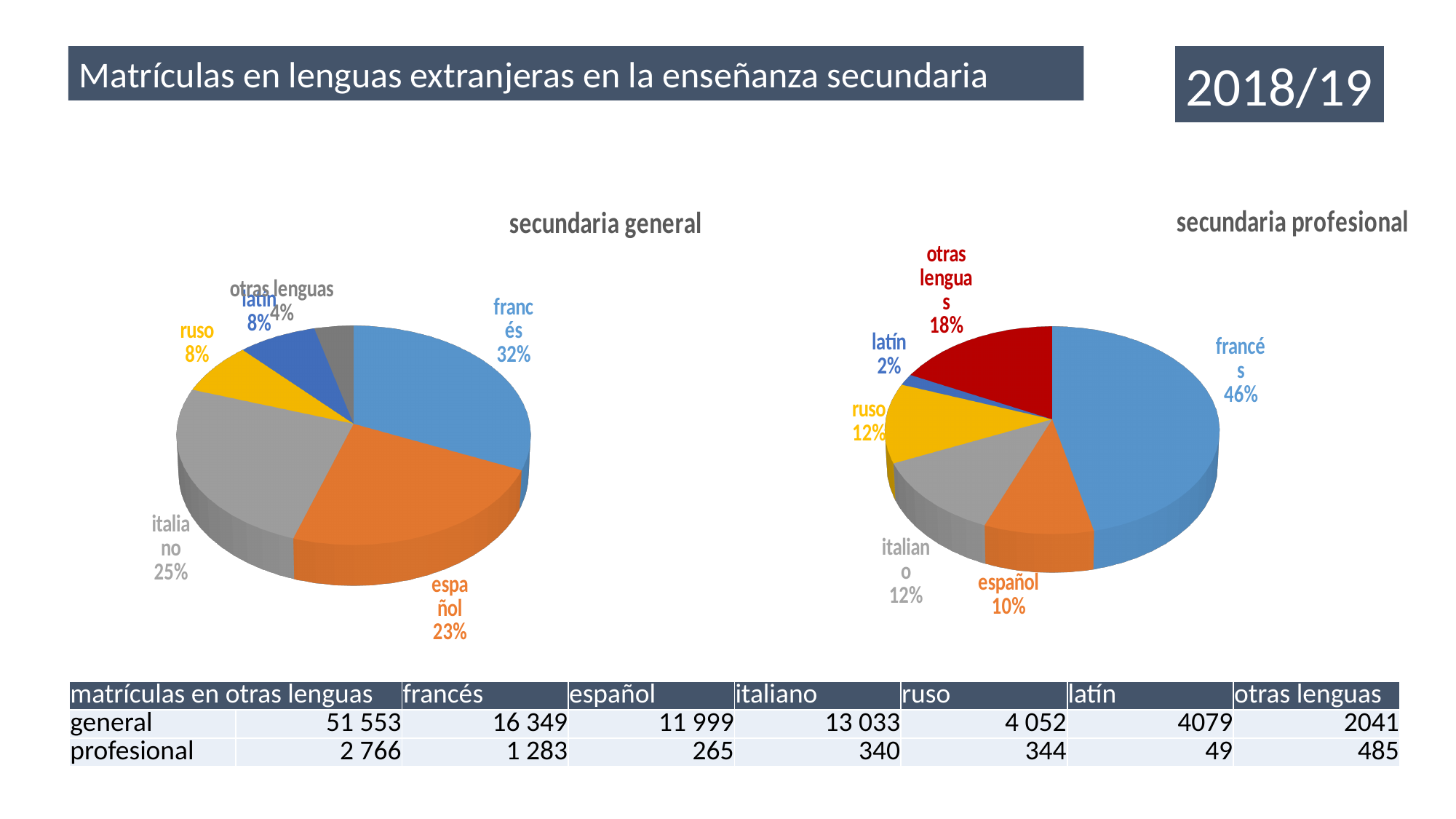
In the 'secundaria general' chart, which language has the largest slice? francés In the 'secundaria profesional' chart, which is larger, the slice for español or the slice for otras lenguas? otras lenguas In the 'secundaria general' chart, how many percentage points larger is francés than español? 9 In the 'secundaria general' chart, which language has the smallest slice? otras lenguas In the 'secundaria profesional' chart, what percentage is shown for otras lenguas? 18% What kind of chart is the 'secundaria general' chart? pie chart In the 'secundaria profesional' chart, what share of the pie does francés have? 46% In the 'secundaria general' chart, what share of the pie does francés have? 32% How many slices does the 'secundaria general' pie chart have? 6 What is the title of the pie chart on the right of the slide? secundaria profesional In the 'secundaria general' chart, what percentage is shown for italiano? 25% In the 'secundaria profesional' chart, which language has the smallest slice? latín